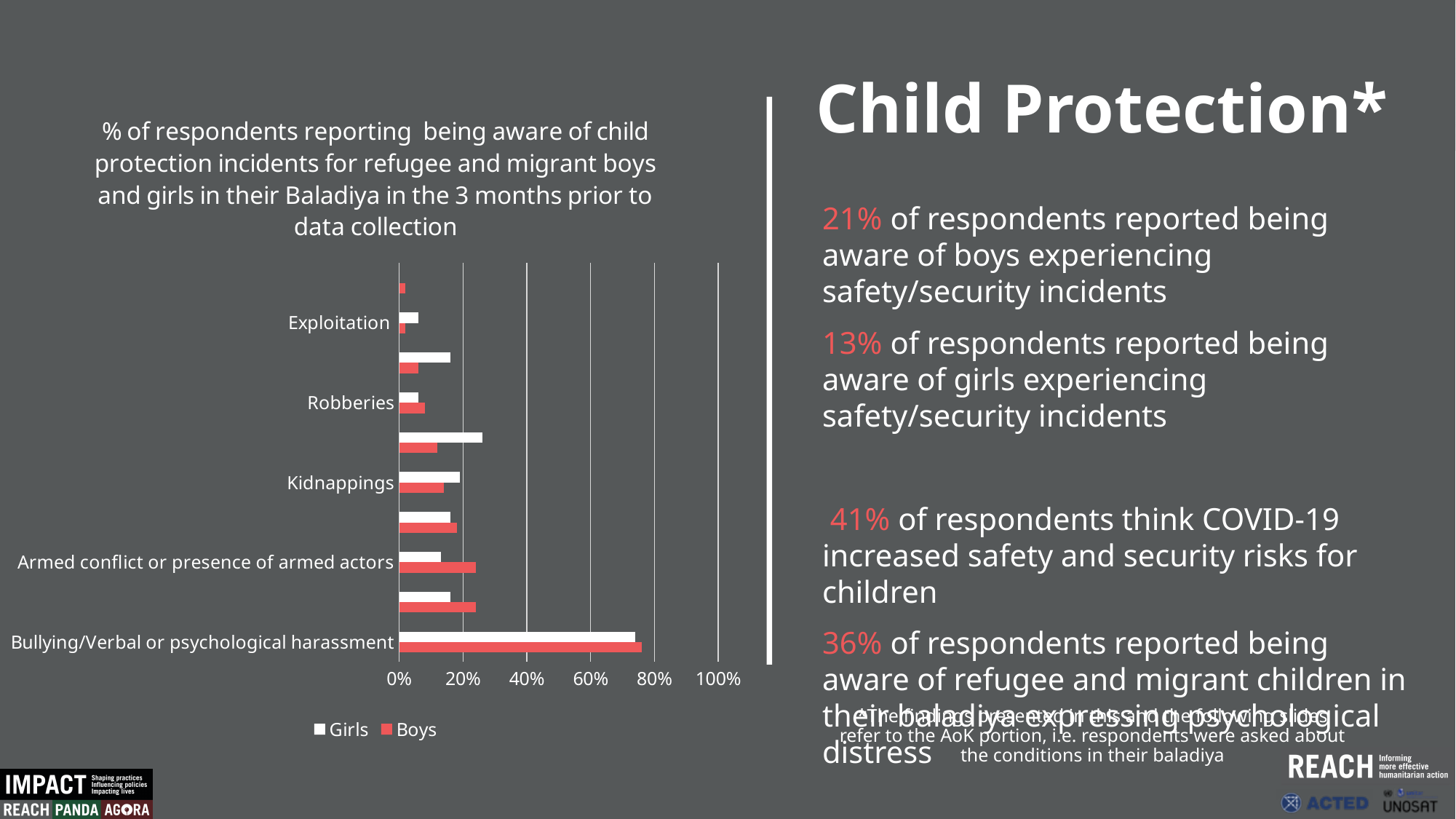
For Armed conflict or presence of armed actors, which is larger: the Girls value or the Boys value? Boys Which category has the highest value for Boys? Bullying/Verbal or psychological harassment Is the Girls value for Robberies greater or less than 20%? less How many series does the chart's legend list? 2 Which colour represents Boys in the chart? red Is the Boys value for Kidnappings greater or less than 20%? less Which category has the highest value for Girls? Bullying/Verbal or psychological harassment What kind of chart is shown on the slide? bar chart Is the Boys value for Armed conflict or presence of armed actors greater or less than 20%? greater What are the two series named in the chart's legend? Girls and Boys